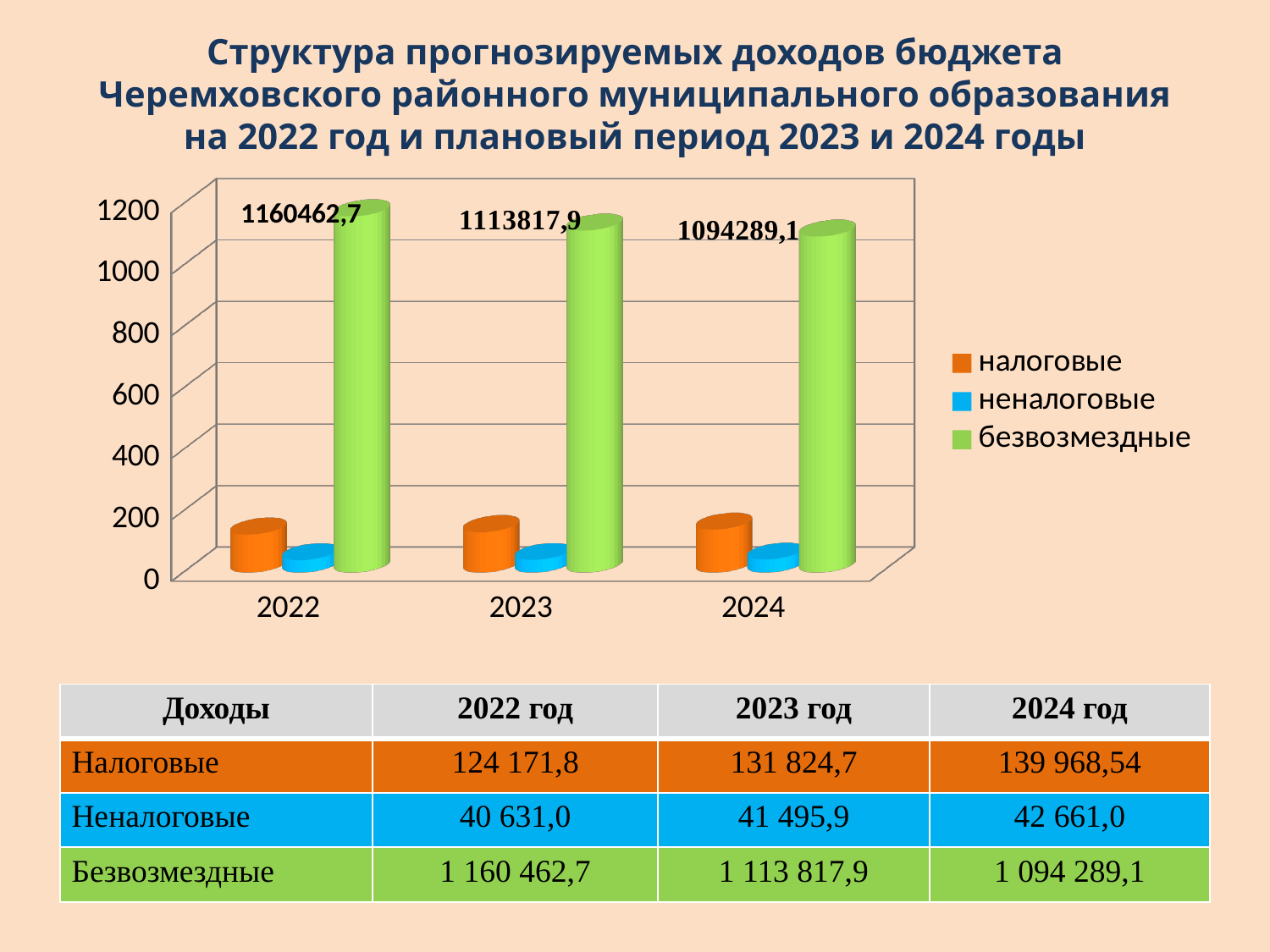
In 2022, which bar is taller: налоговые or неналоговые? налоговые What is the data label on the безвозмездные bar for 2022? 1160462,7 Is the value of the налоговые bar for 2022 greater or less than 200 on the chart axis? less How many series does the chart legend list? 3 What is the difference between the безвозмездные data labels for 2022 and 2023? 46644,8 How many years are shown on the x axis of the chart? 3 What is the data label on the безвозмездные bar for 2024? 1094289,1 Do the безвозмездные values rise or fall from 2022 to 2024? fall In which year is the безвозмездные bar the lowest? 2024 In which year is the безвозмездные bar the highest? 2022 What is the data label on the безвозмездные bar for 2023? 1113817,9 What kind of chart is shown on the slide? bar chart